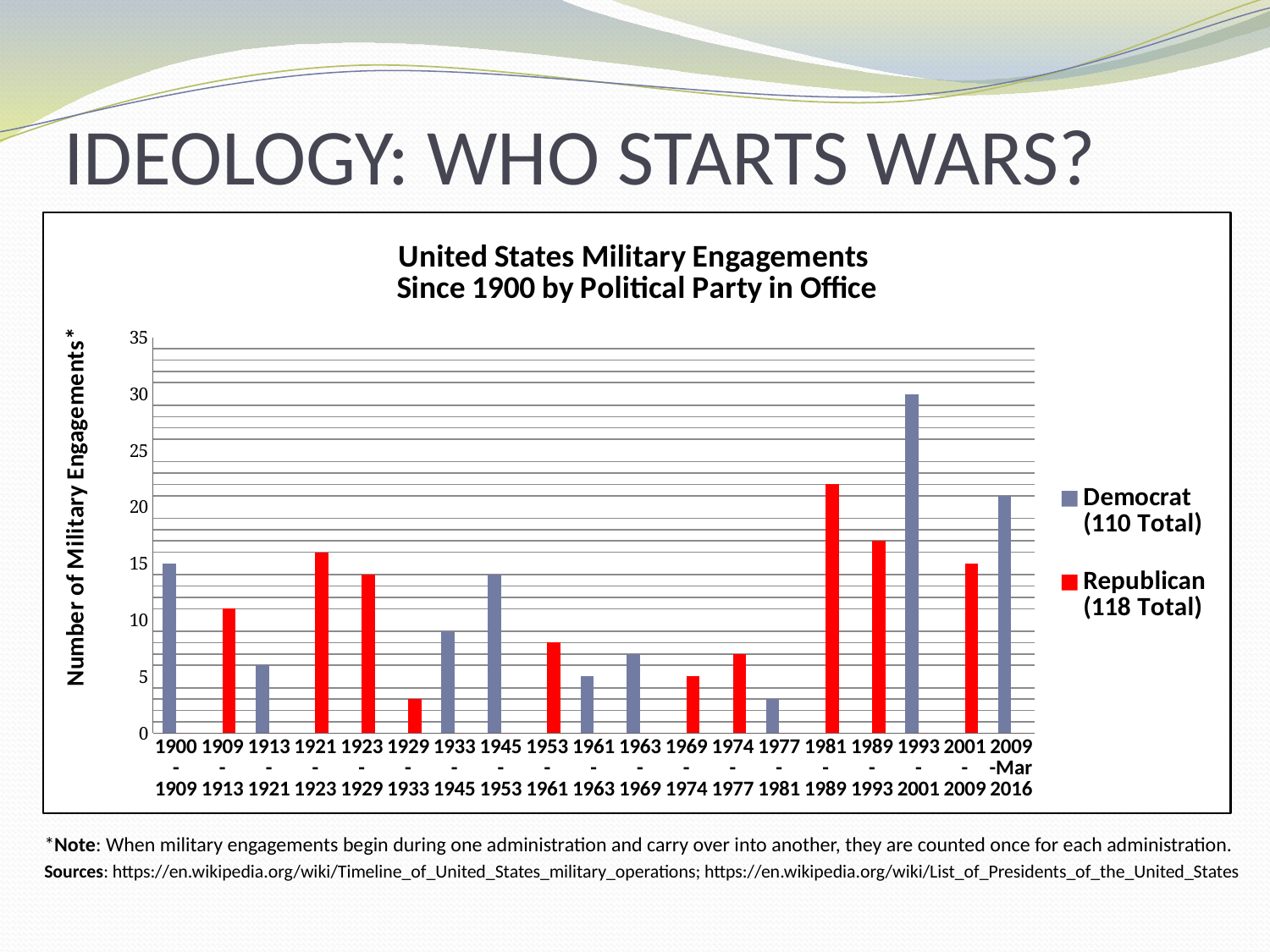
Is the value for 1929-1933 greater or less than 5? less Is the value for 1989-1993 greater or less than 15? greater Is the value for 1945-1953 greater or less than 10? greater How many administration periods (categories) are shown on the x axis? 19 Which has more military engagements, 1900-1909 or 1913-1921? 1900-1909 What type of chart is shown on the slide? bar chart Which has more military engagements, 1981-1989 or 1989-1993? 1981-1989 How many series does the legend list? 2 Which administration period has the highest number of military engagements? 1993-2001 According to the legend, what is the total number of military engagements under Republican administrations? 118 Total